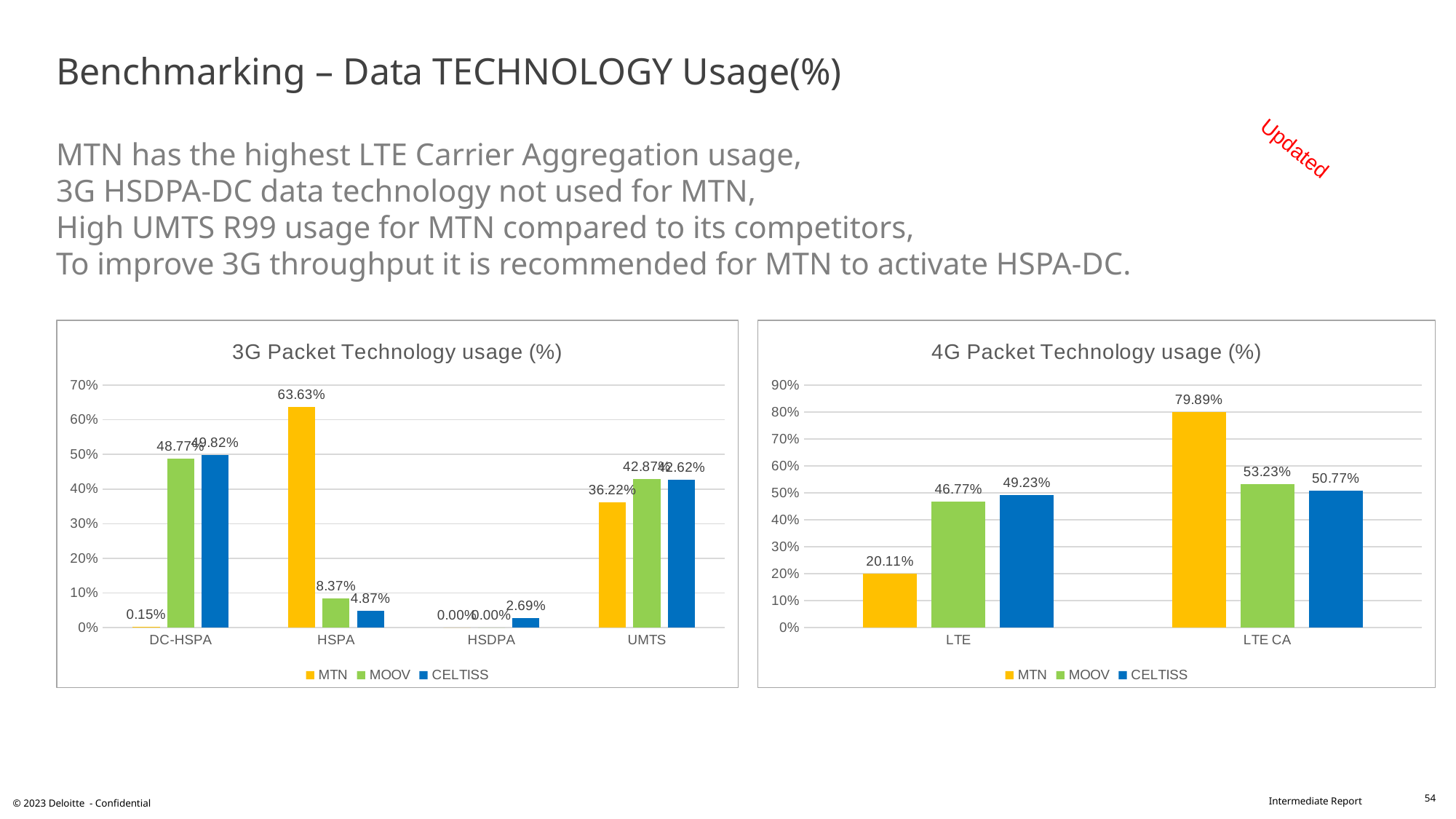
How many categories are shown on the x axis of the 3G Packet Technology usage chart? 4 In the 4G Packet Technology usage chart, which series has the lowest value in the LTE category? MTN In the 3G Packet Technology usage chart, which is larger in the HSPA category: MOOV or CELTISS? MOOV In the 3G Packet Technology usage chart, is the value for MTN in the UMTS category greater or less than 30%? greater In the 3G Packet Technology usage chart, what is the value for MTN in the HSPA category? 63.63% In the 4G Packet Technology usage chart, what is the value for MOOV in the LTE category? 46.77% In the 4G Packet Technology usage chart, what is the difference between MTN's LTE CA value and its LTE value? 59.78% In the 4G Packet Technology usage chart, which series has the highest value in the LTE CA category? MTN What type of chart is the 4G Packet Technology usage chart? Bar chart In the 3G Packet Technology usage chart, what is the value for CELTISS in the HSDPA category? 2.69% How many series does the legend of the 4G Packet Technology usage chart list? 3 In the 4G Packet Technology usage chart, what is the value for MTN in the LTE CA category? 79.89%